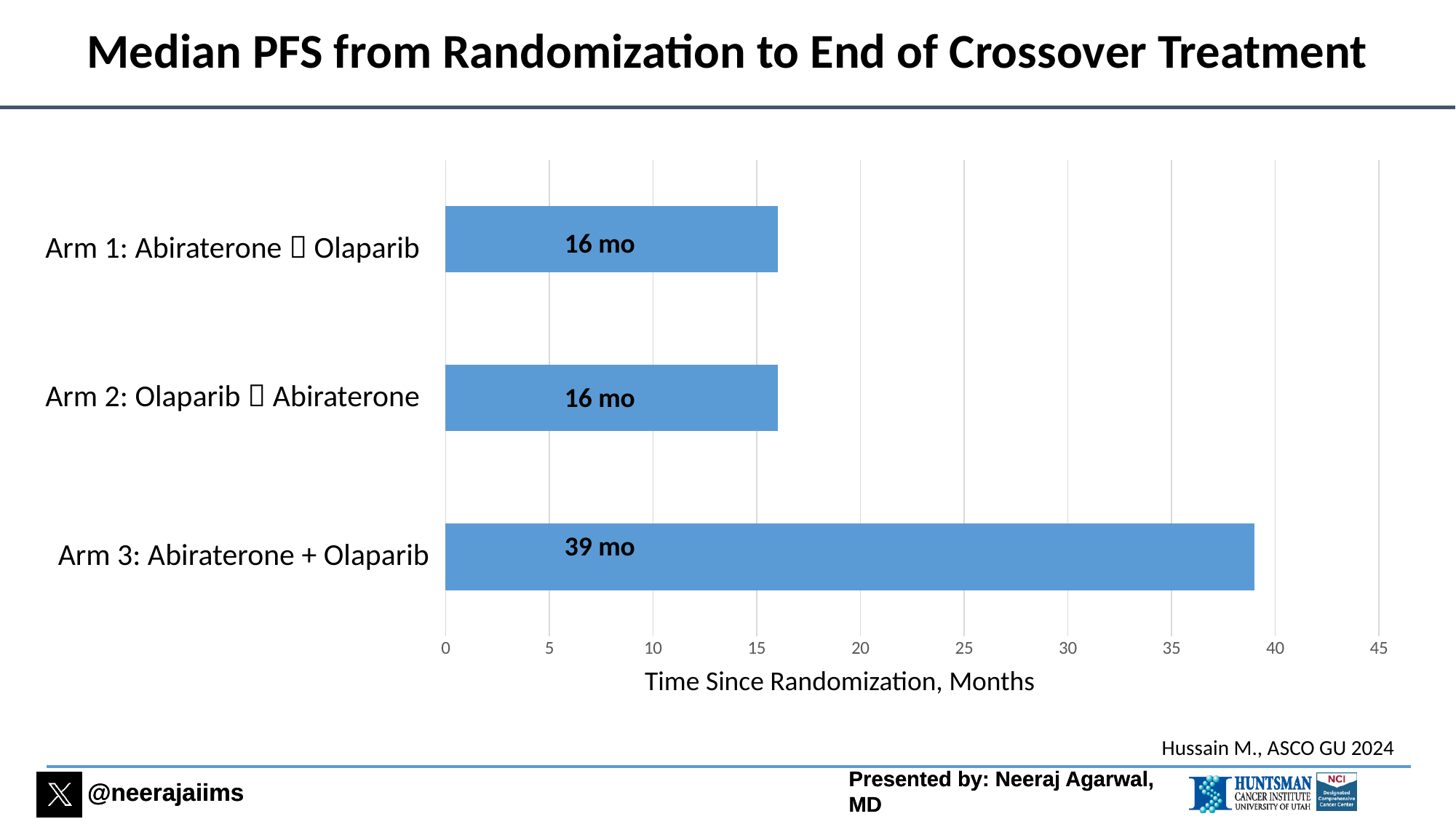
What kind of chart is shown on the slide? Bar chart What is the label of the horizontal axis? Time Since Randomization, Months Is the value for Arm 1: Abiraterone → Olaparib greater or less than 20? less What is the difference in median PFS between Arm 3 and Arm 1? 23 mo Is the value for Arm 3: Abiraterone + Olaparib greater or less than 35? greater Which arm has the highest median PFS? Arm 3: Abiraterone + Olaparib What is the title of the chart? Median PFS from Randomization to End of Crossover Treatment What is the median PFS value shown for Arm 1: Abiraterone → Olaparib? 16 mo What is the median PFS value shown for Arm 3: Abiraterone + Olaparib? 39 mo How many arms (bars) are shown in the chart? 3 What is the median PFS value shown for Arm 2: Olaparib → Abiraterone? 16 mo Which has a larger median PFS, Arm 3: Abiraterone + Olaparib or Arm 2: Olaparib → Abiraterone? Arm 3: Abiraterone + Olaparib